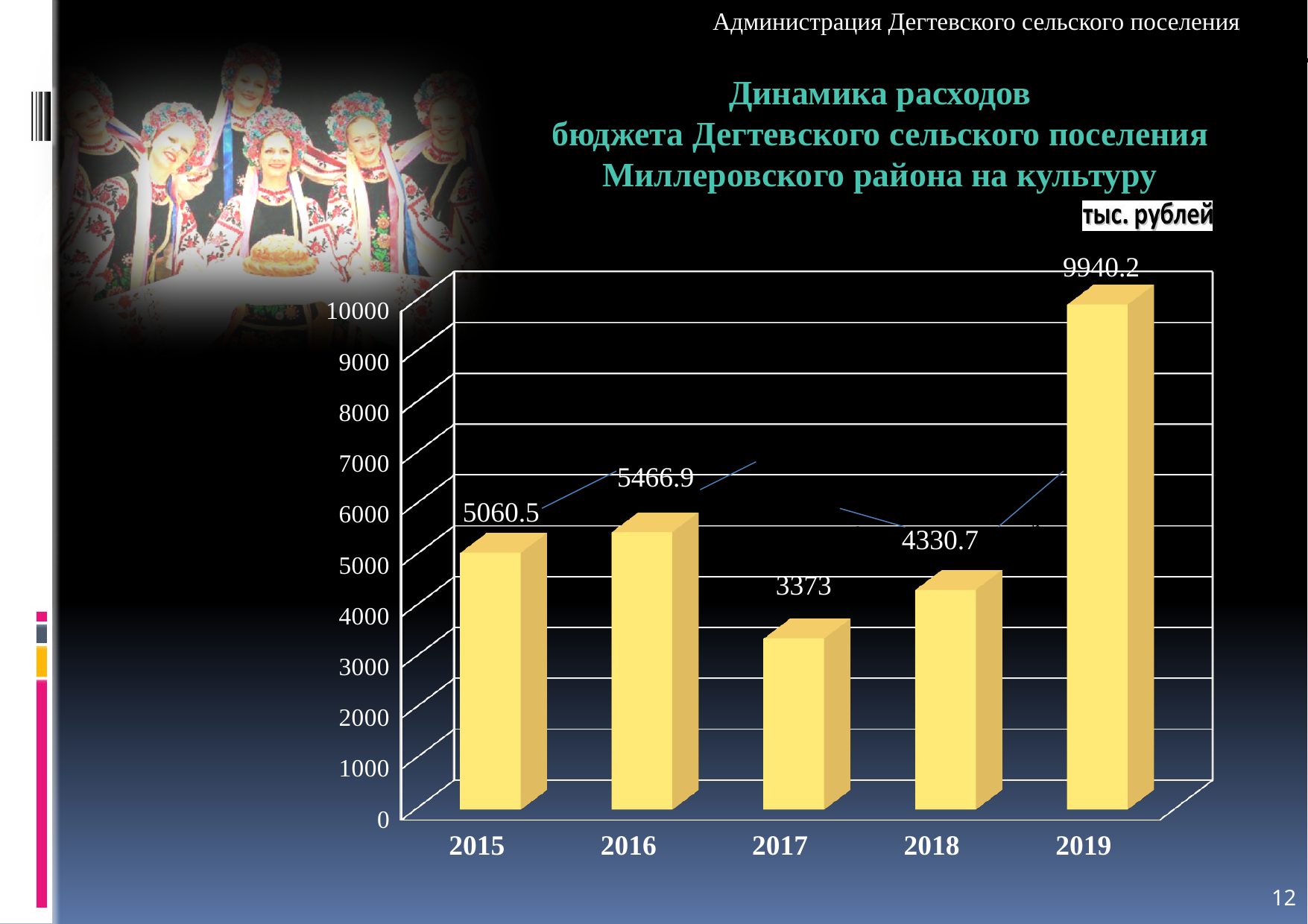
Which year has the lowest value? 2017 What is the value for 2019? 9940.2 How many years are shown on the x axis? 5 In what units are the values on the chart expressed? тыс. рублей What kind of chart is shown on the slide? bar chart Which year has the highest value? 2019 What is the difference between the values for 2016 and 2015? 406.4 Is the value for 2017 greater or less than 4000? less What is the value for 2017? 3373 What is the value for 2015? 5060.5 What is the difference between the values for 2019 and 2018? 5609.5 Which is larger, the value for 2016 or the value for 2018? 2016